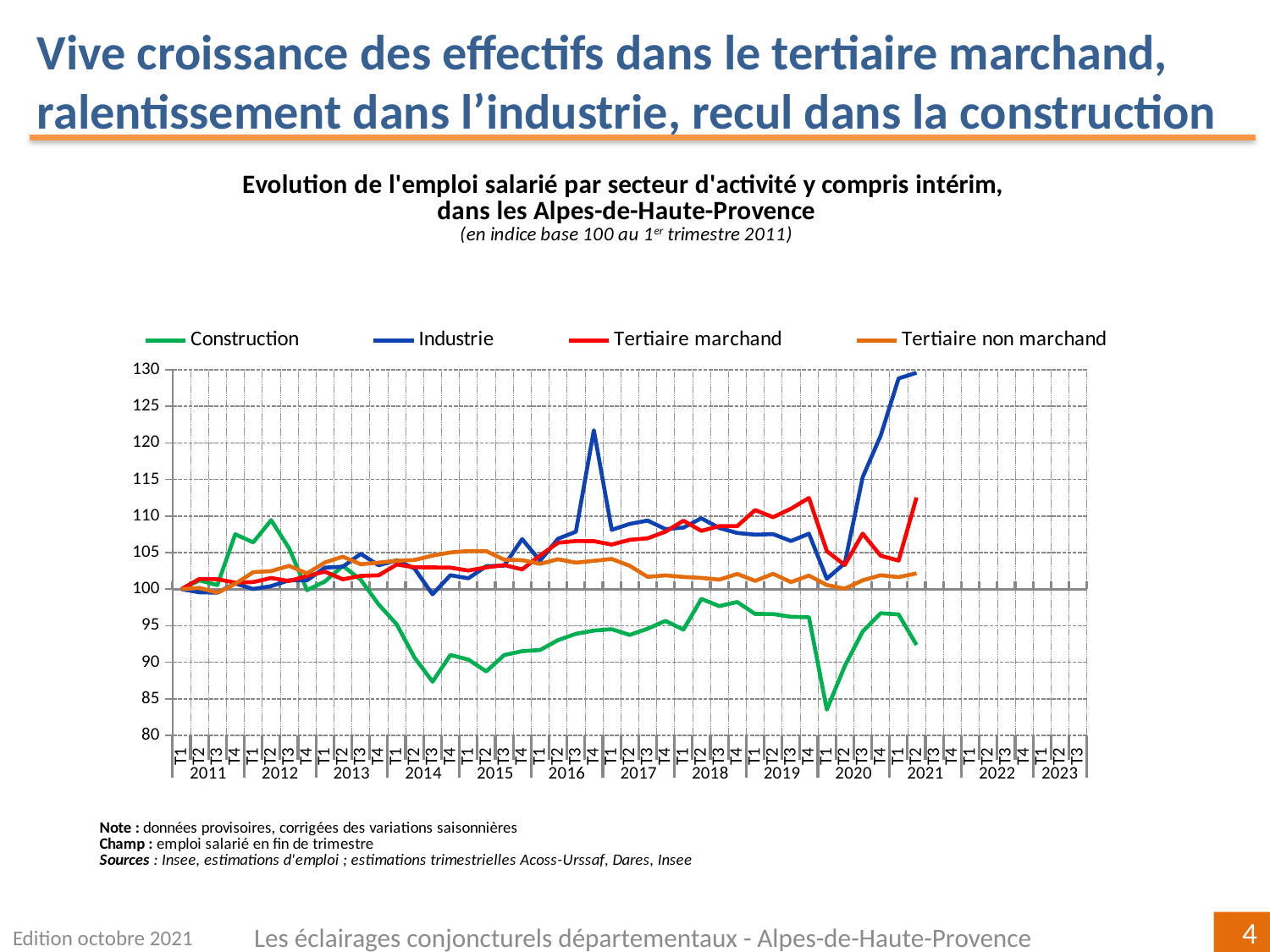
Is the value for Industrie at T4 2016 greater or less than 120? greater What kind of chart is shown on the slide? line chart Which series reaches the highest value on the chart? Industrie At T2 2021, which is larger: Industrie or Construction? Industrie Is the value for Construction at T1 2020 greater or less than 85? less Does the Industrie line rise or fall between T1 2020 and T2 2021? rise Is the value for Industrie at T2 2021 greater or less than 125? greater How many series does the legend list? 4 Which series falls to the lowest value on the chart? Construction What colour is the Construction line in the chart? green At T1 2020, which is larger: Construction or Tertiaire non marchand? Tertiaire non marchand